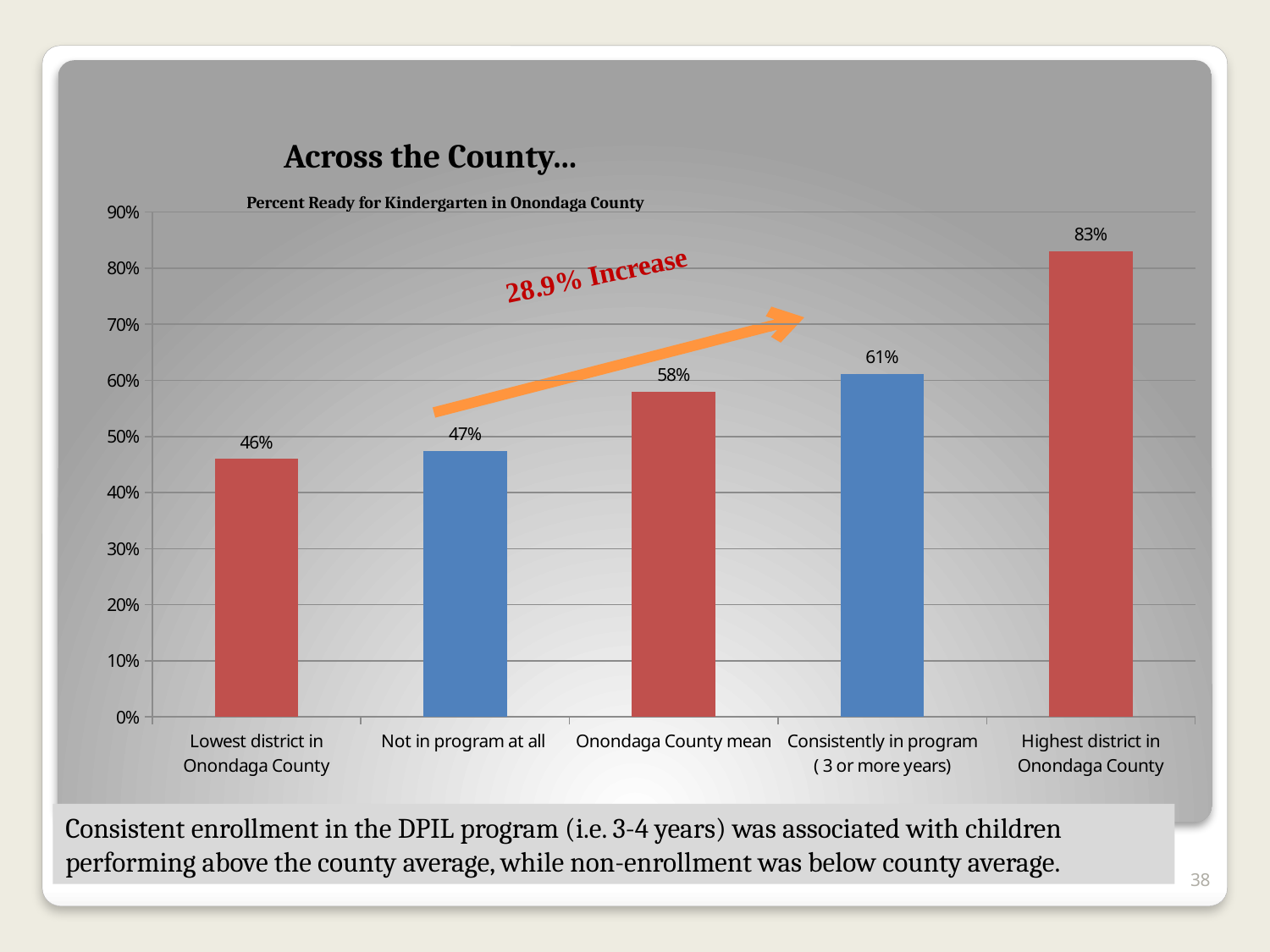
What is the value for "Consistently in program (3 or more years)"? 61% What is the title of the chart? Percent Ready for Kindergarten in Onondaga County How many categories are shown on the x axis? 5 What kind of chart is this? bar chart What is the value for "Not in program at all"? 47% Which category has the lowest value? Lowest district in Onondaga County What is the difference between "Highest district in Onondaga County" and "Lowest district in Onondaga County"? 37% Which category has the highest value? Highest district in Onondaga County Is the value for "Highest district in Onondaga County" greater or less than 80%? greater What is the difference between "Consistently in program (3 or more years)" and "Not in program at all"? 14% What is the value for "Onondaga County mean"? 58% Which is larger, "Consistently in program (3 or more years)" or "Onondaga County mean"? Consistently in program (3 or more years)